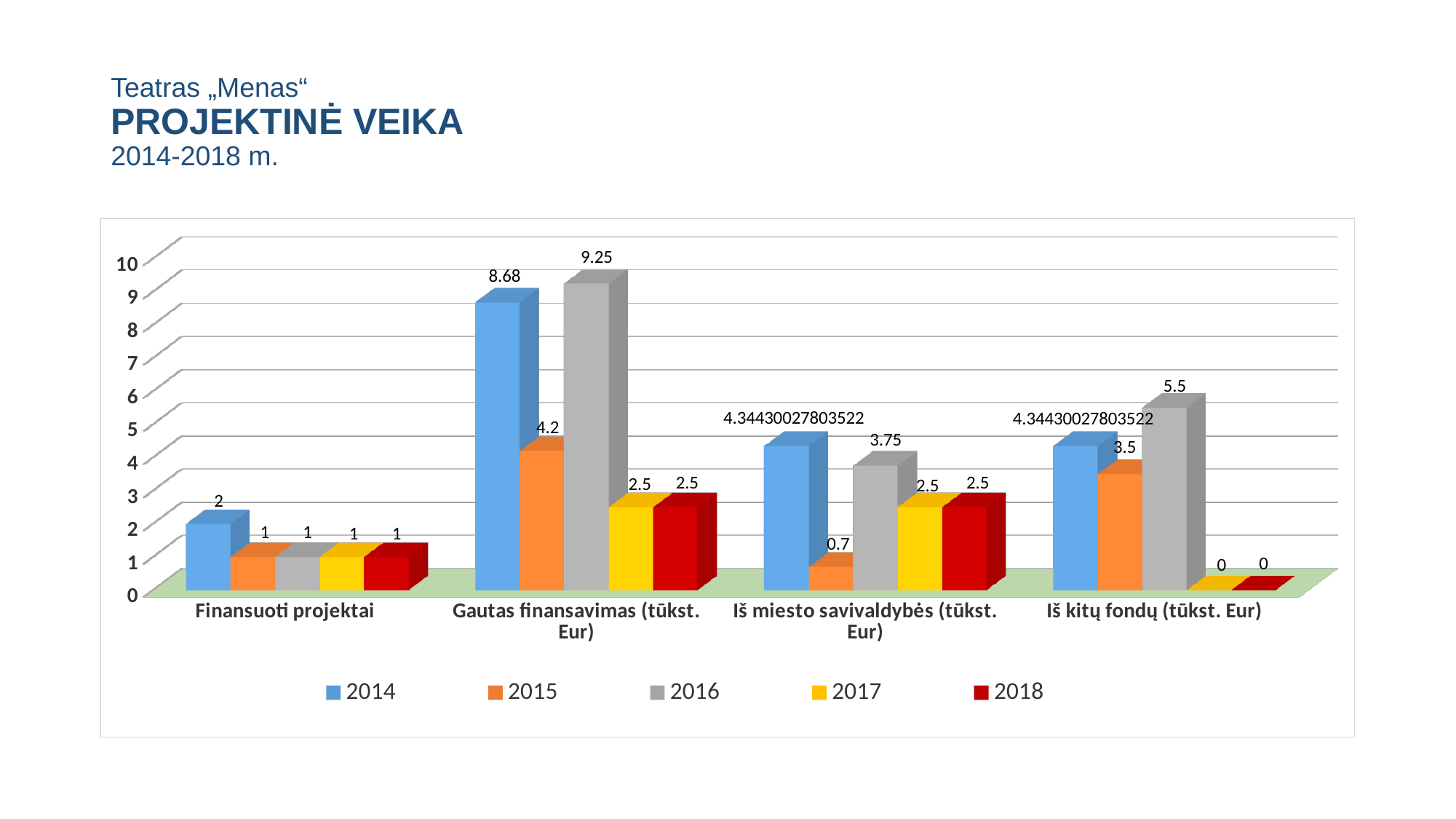
What is the value for 2016 in the "Gautas finansavimas (tūkst. Eur)" category? 9.25 What is the difference between the 2016 and 2014 values in the "Gautas finansavimas (tūkst. Eur)" category? 0.57 In the "Iš kitų fondų (tūkst. Eur)" category, which is larger: the value for 2015 or the value for 2016? 2016 What is the value for 2016 in the "Iš kitų fondų (tūkst. Eur)" category? 5.5 How many categories are shown on the x axis of the chart? 4 Which year has the lowest value in the "Iš miesto savivaldybės (tūkst. Eur)" category? 2015 What is the value for 2015 in the "Iš miesto savivaldybės (tūkst. Eur)" category? 0.7 What is the value for 2017 in the "Iš kitų fondų (tūkst. Eur)" category? 0 What is the value for 2014 in the "Finansuoti projektai" category? 2 What kind of chart is shown on the slide? Bar chart Which year has the highest value in the "Gautas finansavimas (tūkst. Eur)" category? 2016 How many series does the legend list? 5